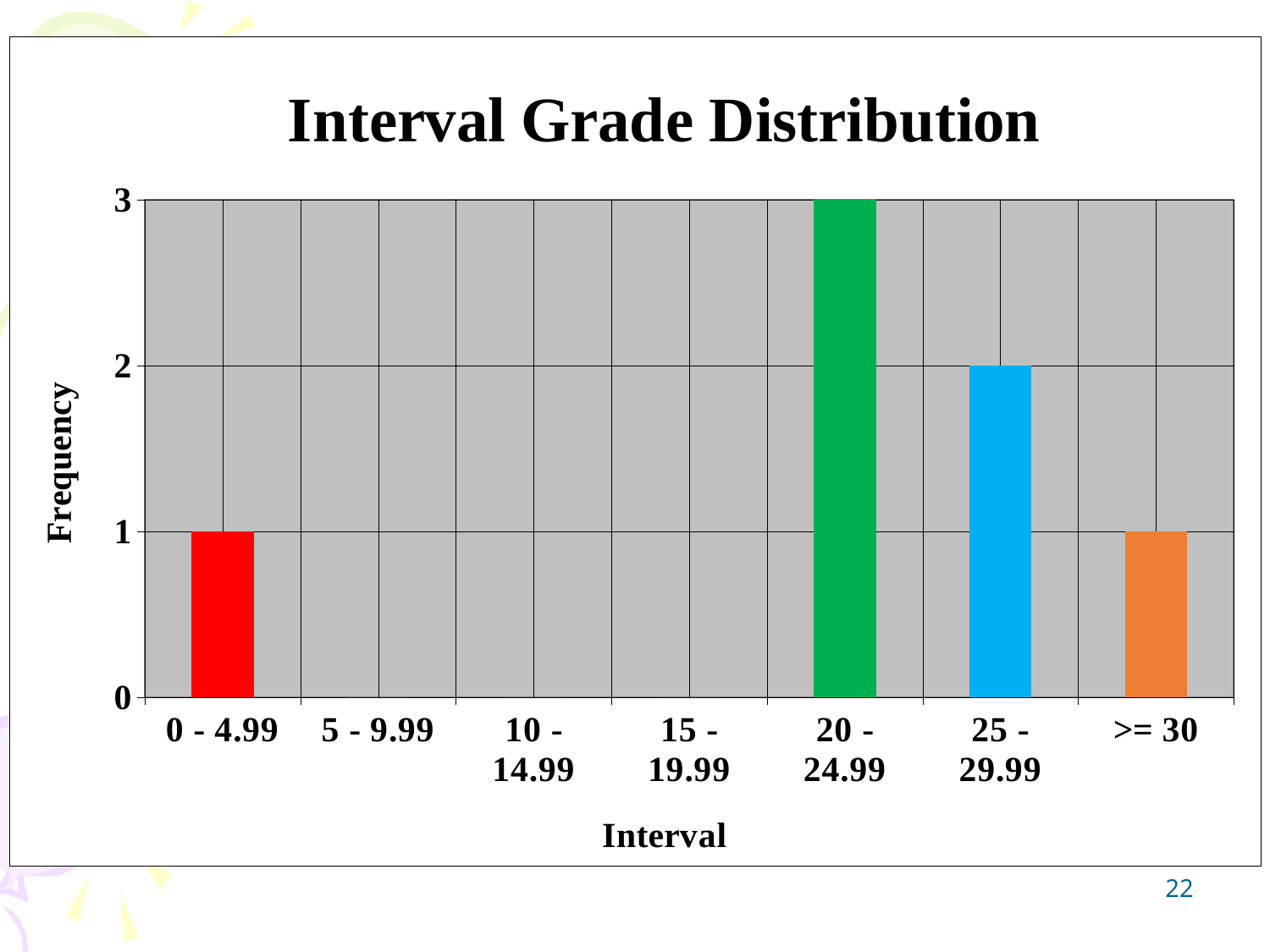
What is the frequency for the interval 20 - 24.99? 3 What is the frequency for the interval 0 - 4.99? 1 What is the frequency for the interval 25 - 29.99? 2 What kind of chart is shown on the slide? Bar chart Which interval has the highest frequency? 20 - 24.99 What is the difference in frequency between the 20 - 24.99 interval and the 25 - 29.99 interval? 1 What is the frequency for the interval >= 30? 1 What is the title of the chart? Interval Grade Distribution How many intervals are shown on the x axis? 7 What is the label of the y axis? Frequency What is the frequency for the interval 10 - 14.99? 0 Which has a higher frequency, the 25 - 29.99 interval or the >= 30 interval? 25 - 29.99